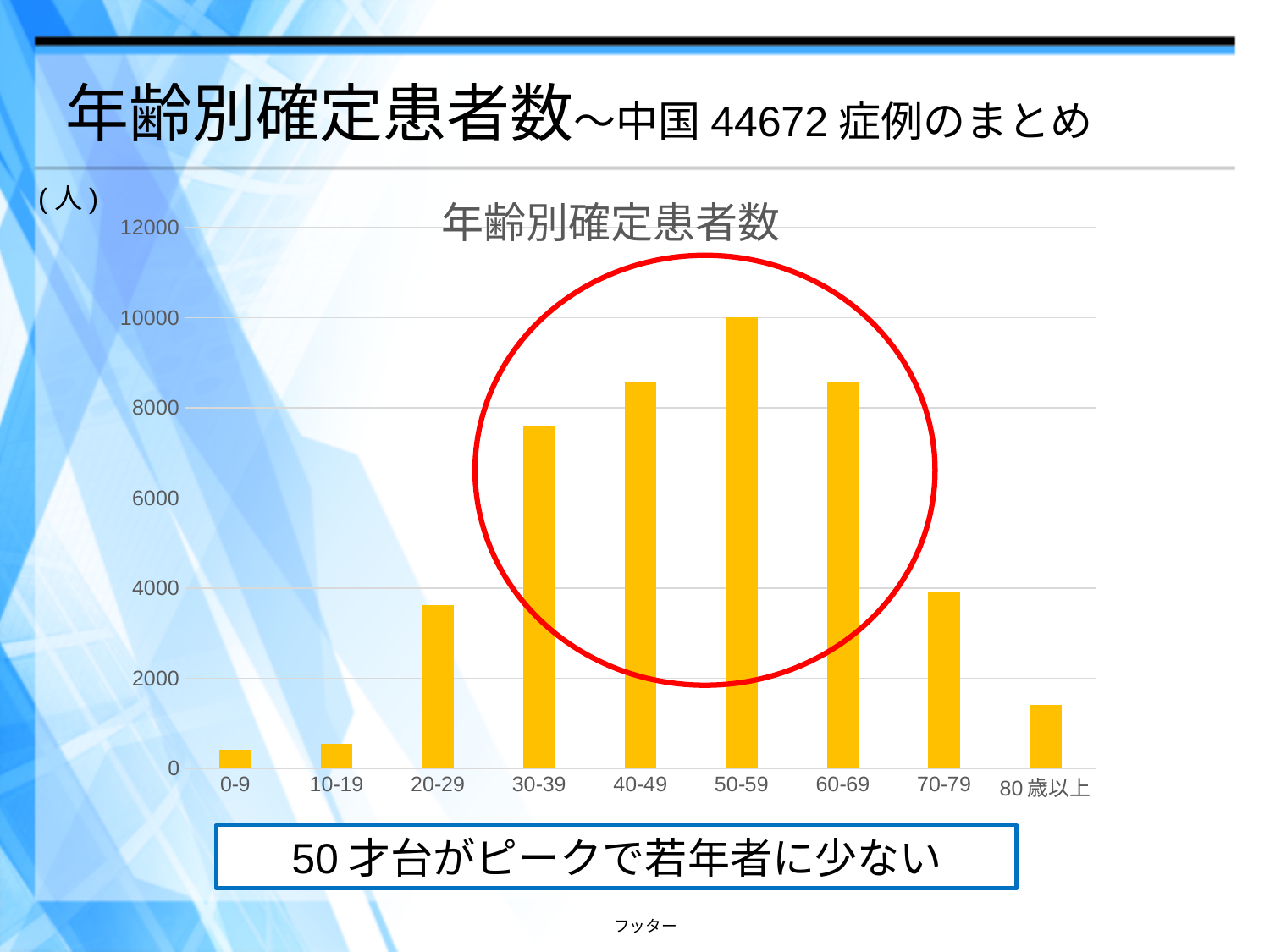
Is the value for 0-9 greater or less than 2000? less Is the value for 30-39 greater or less than 6000? greater What is the title of the chart? 年齢別確定患者数 Which is larger, the value for 20-29 or the value for 80歳以上? 20-29 Which is larger, the value for 30-39 or the value for 70-79? 30-39 How many age categories are shown on the x axis of the chart? 9 Which age category has the highest number of confirmed patients? 50-59 Is the value for 50-59 greater or less than 8000? greater What kind of chart is shown on the slide? bar chart What colour are the bars in the chart? yellow (orange-yellow)